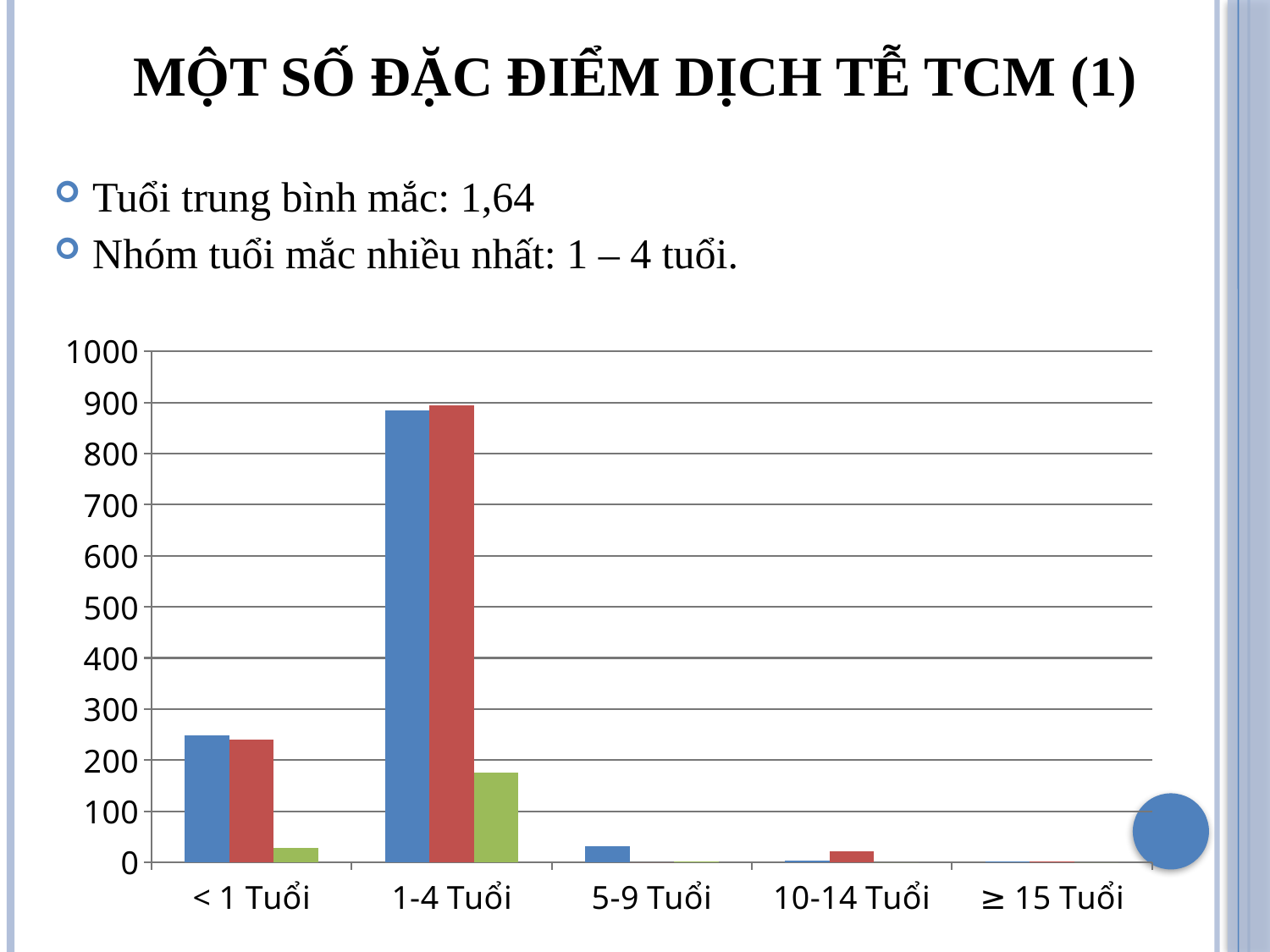
Which is larger, the blue bar for < 1 Tuổi or the blue bar for 5-9 Tuổi? < 1 Tuổi How many age-group categories are shown on the x axis of the chart? 5 Is the value of the green bar for 1-4 Tuổi greater or less than 200? less Which is larger, the green bar for 1-4 Tuổi or the green bar for < 1 Tuổi? 1-4 Tuổi What kind of chart is shown on the slide? bar chart Is the value of the blue bar for < 1 Tuổi greater or less than 200? greater Is the value of the blue bar for 1-4 Tuổi greater or less than 800? greater What is the maximum value shown on the y axis of the chart? 1000 What is the label of the last category on the x axis of the chart? ≥ 15 Tuổi Which age group has the highest bars in the chart? 1-4 Tuổi